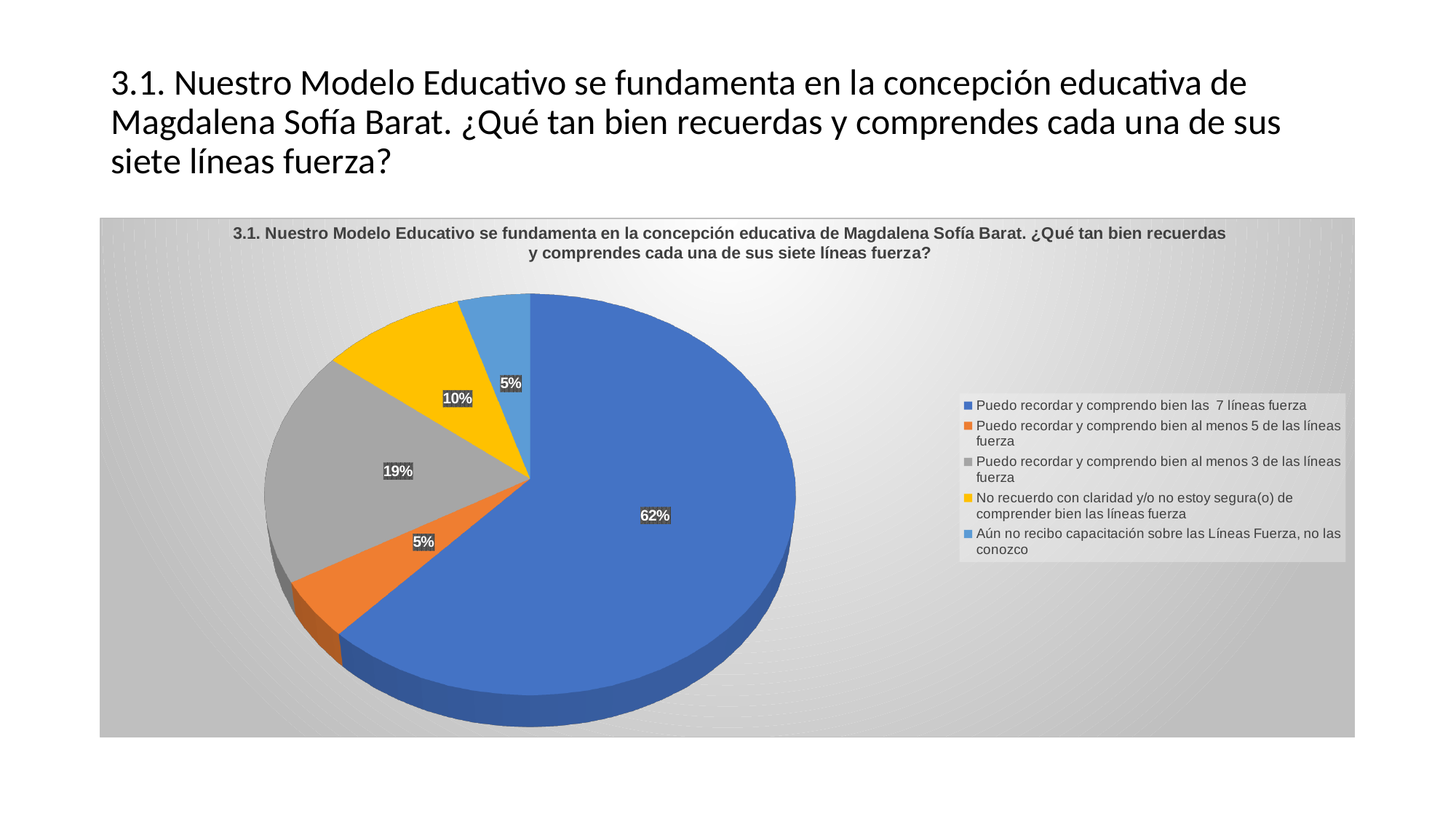
What percentage of respondents said 'Puedo recordar y comprendo bien las 7 líneas fuerza'? 62% What is the difference in percentage points between 'Puedo recordar y comprendo bien las 7 líneas fuerza' and 'Puedo recordar y comprendo bien al menos 3 de las líneas fuerza'? 43 Which is larger: the share for 'Puedo recordar y comprendo bien al menos 3 de las líneas fuerza' or the share for 'No recuerdo con claridad y/o no estoy segura(o) de comprender bien las líneas fuerza'? Puedo recordar y comprendo bien al menos 3 de las líneas fuerza Which response category has the largest share of the pie? Puedo recordar y comprendo bien las 7 líneas fuerza What percentage of respondents said 'No recuerdo con claridad y/o no estoy segura(o) de comprender bien las líneas fuerza'? 10% How many categories does the legend list? 5 What colour is the largest slice of the pie? Blue What percentage of respondents said 'Aún no recibo capacitación sobre las Líneas Fuerza, no las conozco'? 5% What percentage of respondents said 'Puedo recordar y comprendo bien al menos 3 de las líneas fuerza'? 19% What type of chart is shown on the slide? Pie chart What colour is the slice representing 'Puedo recordar y comprendo bien al menos 5 de las líneas fuerza'? Orange What is the combined share of 'No recuerdo con claridad y/o no estoy segura(o) de comprender bien las líneas fuerza' and 'Aún no recibo capacitación sobre las Líneas Fuerza, no las conozco'? 15%